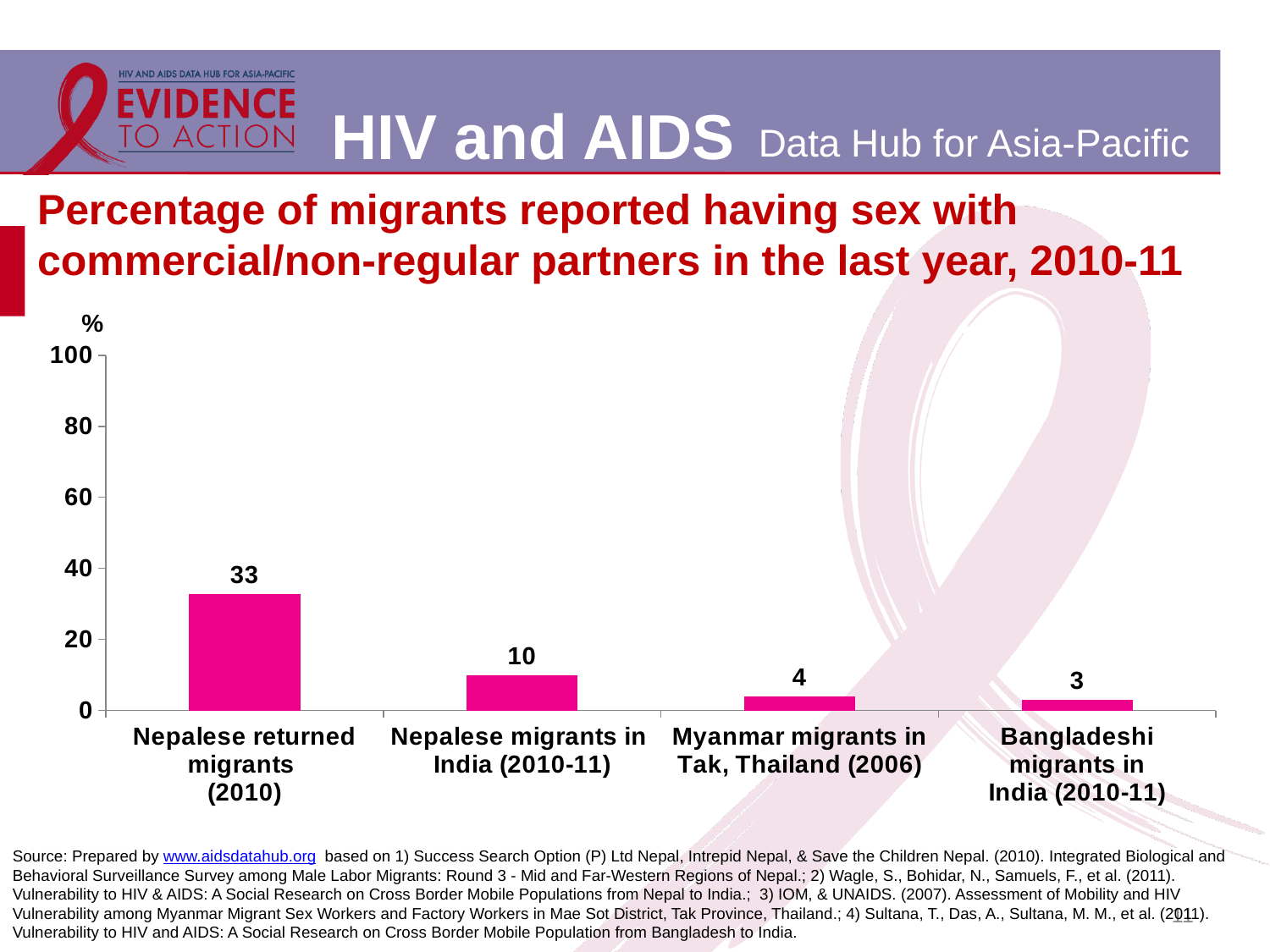
What is the difference between the values for Nepalese returned migrants (2010) and Nepalese migrants in India (2010-11)? 23 What is the value for Bangladeshi migrants in India (2010-11)? 3 What is the value for Nepalese migrants in India (2010-11)? 10 What is the maximum value shown on the vertical axis? 100 How many categories are shown in the chart? 4 Which is larger: the value for Myanmar migrants in Tak, Thailand (2006) or Bangladeshi migrants in India (2010-11)? Myanmar migrants in Tak, Thailand (2006) Which category has the highest value? Nepalese returned migrants (2010) What kind of chart is shown on the slide? bar chart What is the value for Myanmar migrants in Tak, Thailand (2006)? 4 What is the value for Nepalese returned migrants (2010)? 33 Is the value for Nepalese returned migrants (2010) greater or less than 20? greater Which category has the lowest value? Bangladeshi migrants in India (2010-11)